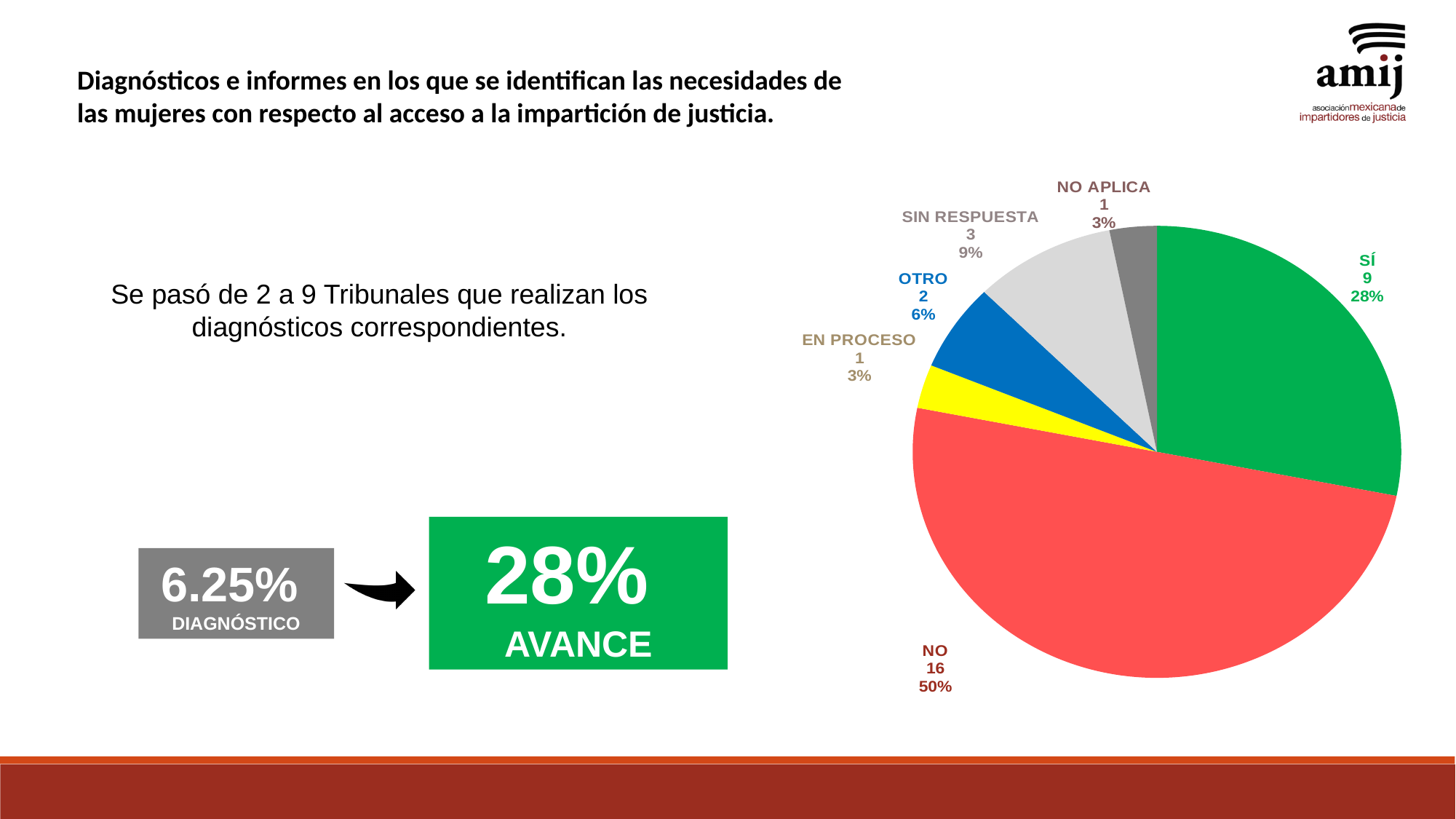
What is the count for the NO slice? 16 What is the count for EN PROCESO? 1 What kind of chart is shown on the slide? pie chart What percentage share does the SÍ slice have? 28% What is the difference between the NO count and the SÍ count? 7 How many slices does the pie chart have? 6 What colour is the NO slice? red Which is larger, the SIN RESPUESTA slice or the OTRO slice? SIN RESPUESTA What percentage share does the OTRO slice have? 6% What percentage share does the NO slice have? 50% What is the count for SIN RESPUESTA? 3 Which category has the largest slice? NO